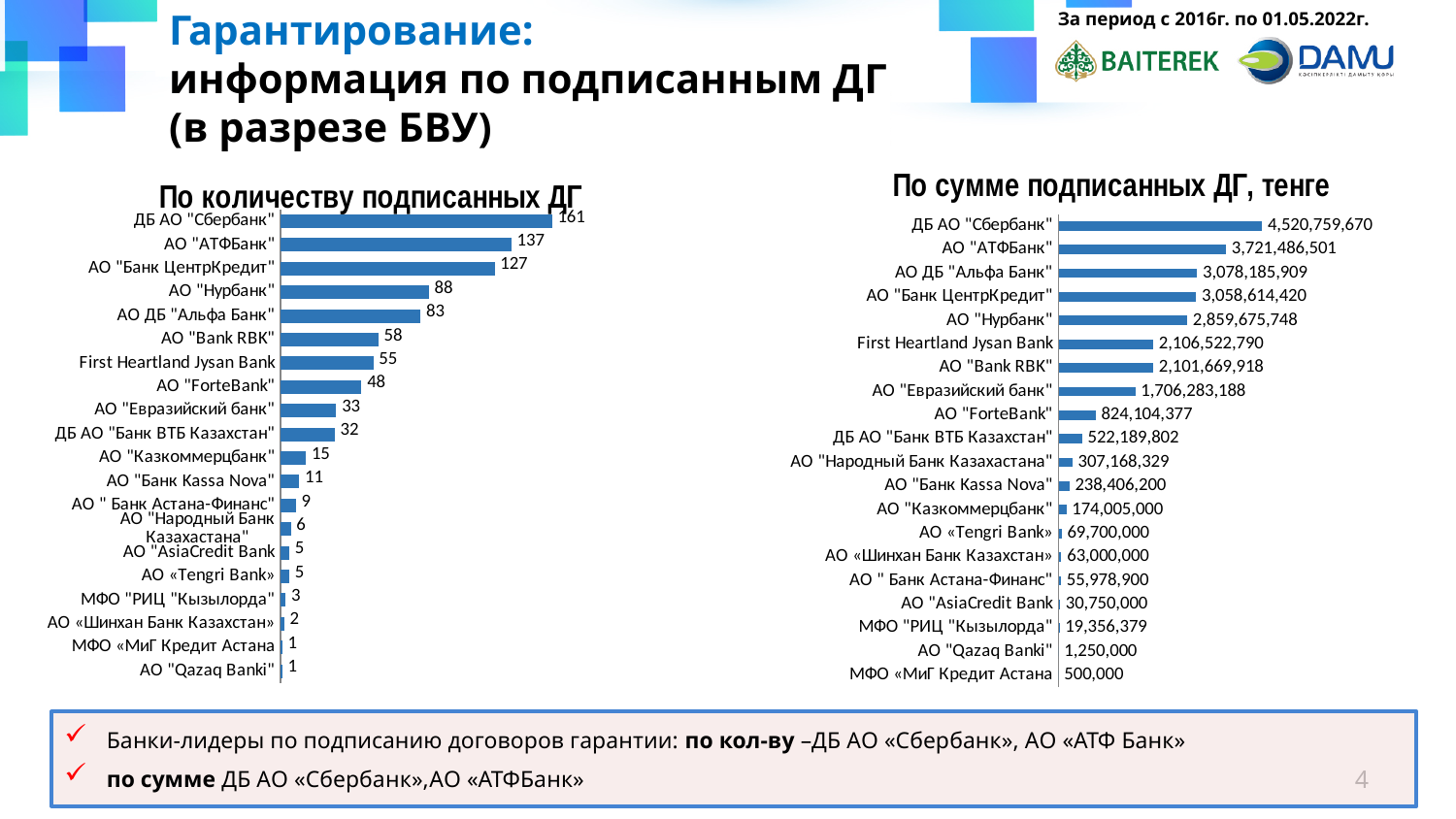
In the chart "По количеству подписанных ДГ", which is larger: АО "Евразийский банк" or АО "Казкоммерцбанк"? АО "Евразийский банк" In the chart "По количеству подписанных ДГ", how many banks are listed? 20 In the chart "По сумме подписанных ДГ, тенге", which bank has the lowest value? МФО «МиГ Кредит Астана» In the chart "По сумме подписанных ДГ, тенге", what is the value for АО ДБ "Альфа Банк"? 3,078,185,909 In the chart "По количеству подписанных ДГ", what is the value for АО "Bank RBK"? 58 In the chart "По количеству подписанных ДГ", which bank has the highest value? ДБ АО "Сбербанк" In the chart "По сумме подписанных ДГ, тенге", what is the value for АО «Tengri Bank»? 69,700,000 In the chart "По количеству подписанных ДГ", what is the value for АО "Нурбанк"? 88 In the chart "По сумме подписанных ДГ, тенге", which is larger: АО "ForteBank" or ДБ АО "Банк ВТБ Казахстан"? АО "ForteBank" In the chart "По количеству подписанных ДГ", what is the difference between ДБ АО "Сбербанк" and АО "АТФБанк"? 24 In the chart "По сумме подписанных ДГ, тенге", what is the difference between ДБ АО "Сбербанк" and АО "АТФБанк"? 799,273,169 What type of chart is "По сумме подписанных ДГ, тенге"? Bar chart